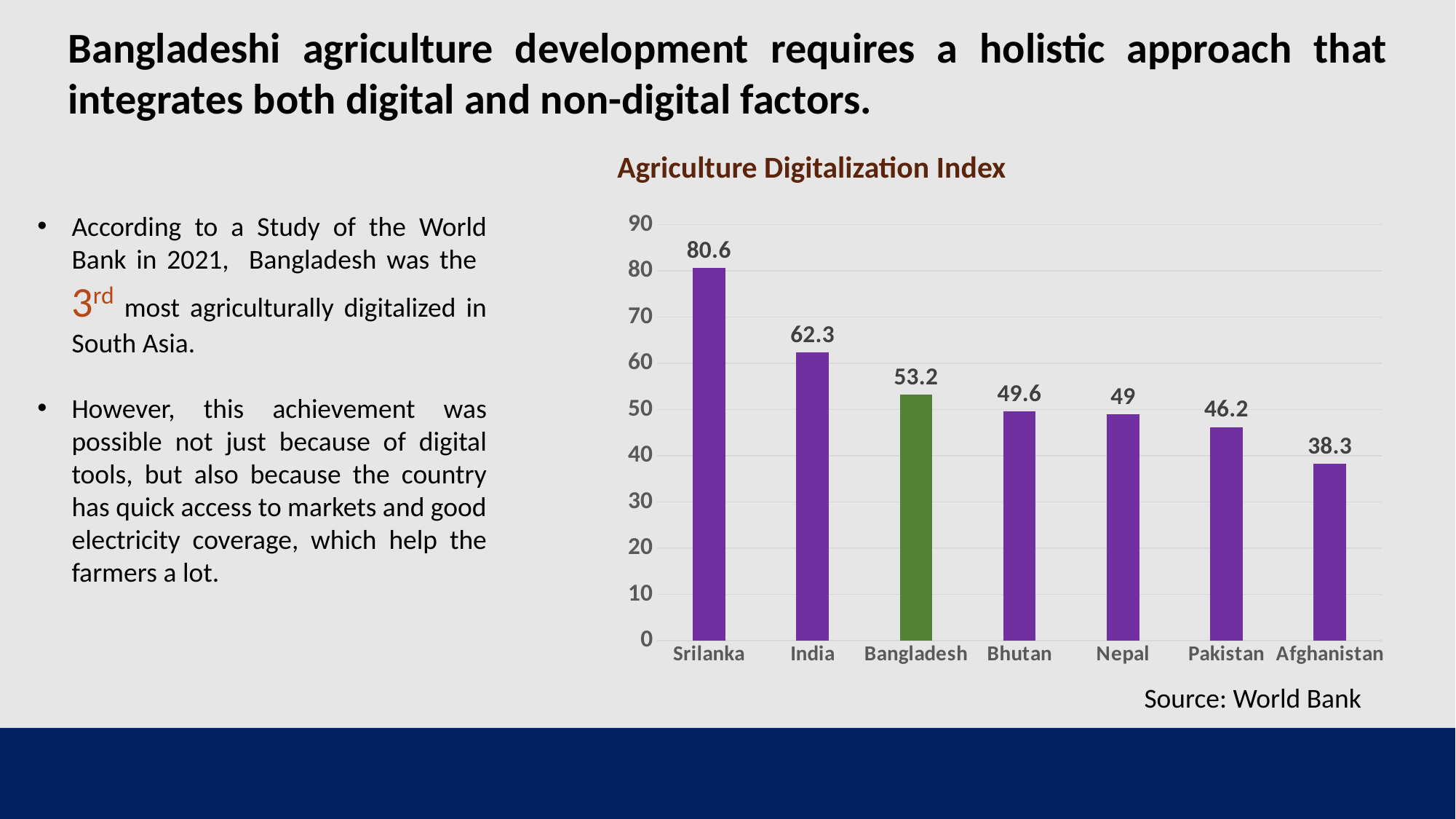
What is the difference between the Agriculture Digitalization Index values of Srilanka and India? 18.3 Is the Agriculture Digitalization Index value for Pakistan greater or less than 50? less Which has a higher Agriculture Digitalization Index, India or Bhutan? India What is the Agriculture Digitalization Index value for Bangladesh? 53.2 What is the Agriculture Digitalization Index value for Afghanistan? 38.3 What is the Agriculture Digitalization Index value for Srilanka? 80.6 How many countries are shown in the Agriculture Digitalization Index chart? 7 Which country's bar is coloured green in the Agriculture Digitalization Index chart? Bangladesh Which country has the lowest Agriculture Digitalization Index? Afghanistan Which country has the highest Agriculture Digitalization Index? Srilanka What kind of chart is used to show the Agriculture Digitalization Index? Bar chart What is the difference between the Agriculture Digitalization Index values of Bangladesh and Afghanistan? 14.9